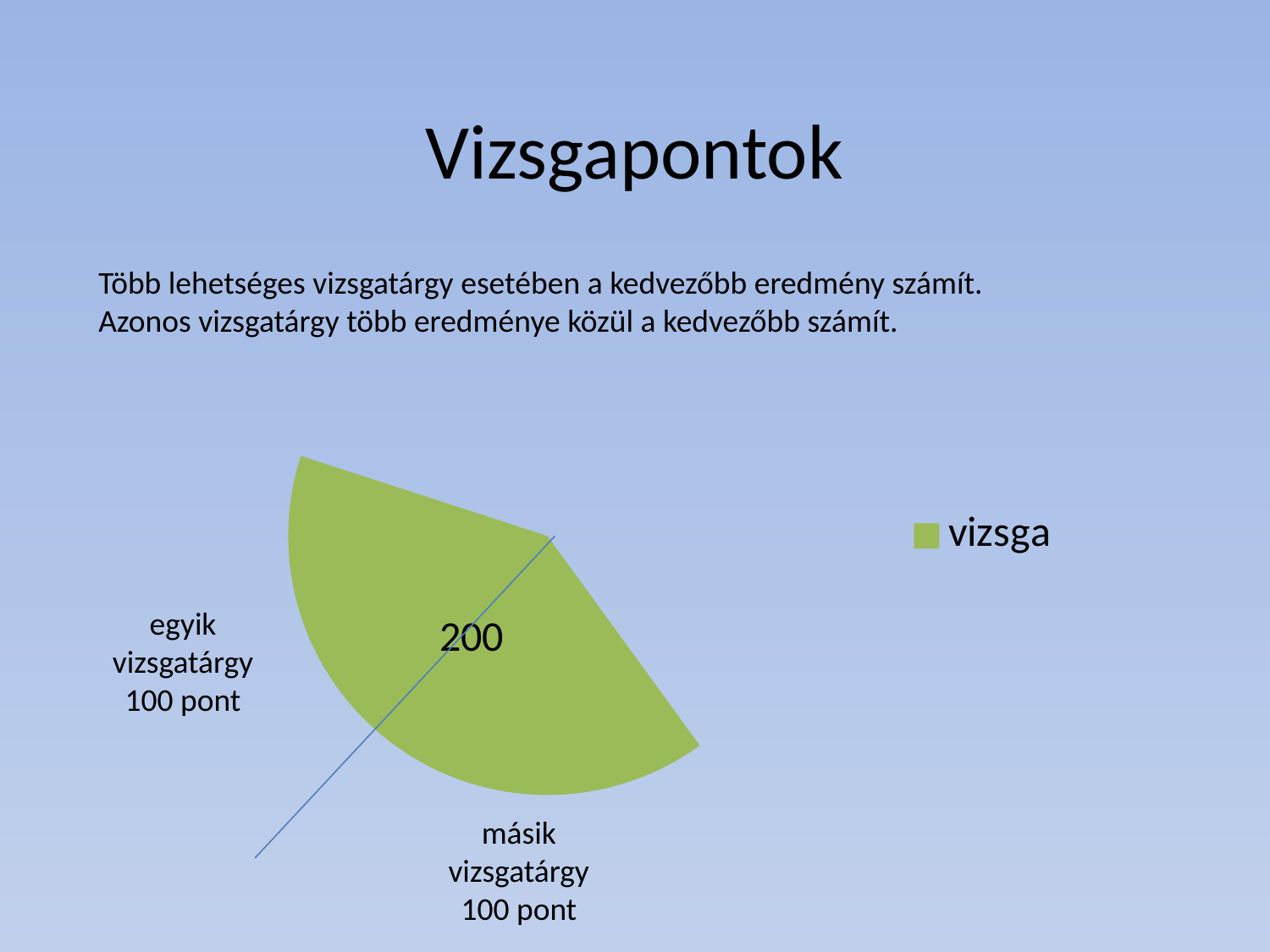
What kind of chart is shown on the slide? pie chart What colour is the slice labelled 200 in the pie chart? green What is the name of the series shown in the legend of the pie chart? vizsga How many entries does the legend of the pie chart list? 1 How many data labels are printed on the pie chart? 1 What value is printed on the green slice of the pie chart? 200